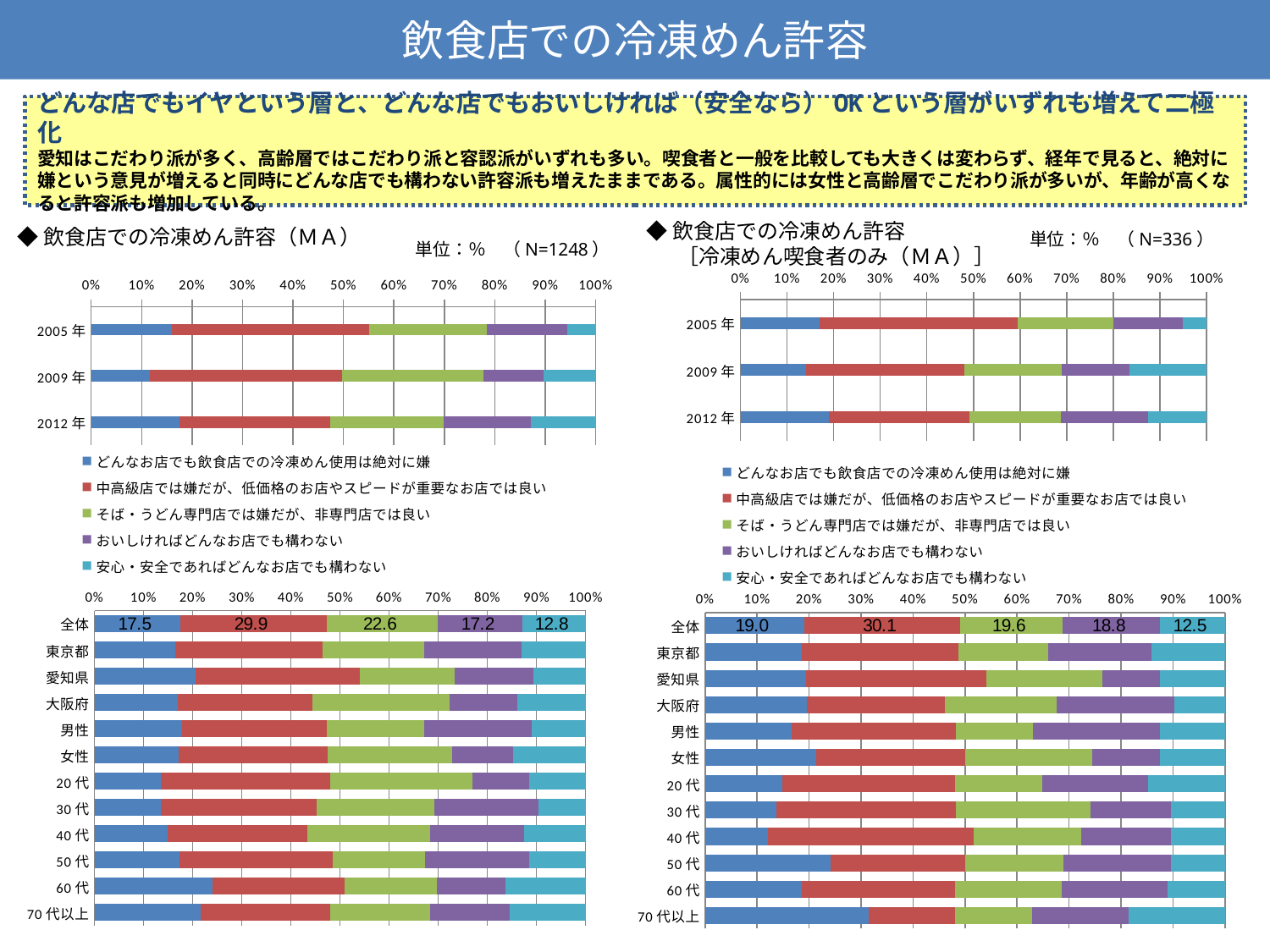
What kind of chart is the top-right chart (冷凍めん喫食者のみ)? Stacked bar chart In the bottom-left chart (N=1248), for 全体, what is the difference between the value for 中高級店では嫌だが、低価格のお店やスピードが重要なお店では良い and the value for どんなお店でも飲食店での冷凍めん使用は絶対に嫌? 12.4 How many series does the legend of the top-left chart list? 5 In the bottom-left chart (飲食店での冷凍めん許容, N=1248), what is the value for 全体 in the series どんなお店でも飲食店での冷凍めん使用は絶対に嫌? 17.5 In the bottom-left chart (N=1248), what is the total of the 全体 bar? 100.0 In the bottom-right chart (N=336), which series has the highest value for 全体? 中高級店では嫌だが、低価格のお店やスピードが重要なお店では良い In the bottom-right chart (N=336), what is the value for 全体 in the series おいしければどんなお店でも構わない? 18.8 In the bottom-left chart (N=1248), what is the value for 全体 in the series 安心・安全であればどんなお店でも構わない? 12.8 In the bottom-left chart (N=1248), for 全体, which is larger: そば・うどん専門店では嫌だが、非専門店では良い or おいしければどんなお店でも構わない? そば・うどん専門店では嫌だが、非専門店では良い In the bottom-right chart (冷凍めん喫食者のみ, N=336), what is the value for 全体 in the series 中高級店では嫌だが、低価格のお店やスピードが重要なお店では良い? 30.1 How many categories are shown on the y axis of the bottom-left chart (N=1248)? 12 In the top-left chart (N=1248), is the value for 2005年 in the series どんなお店でも飲食店での冷凍めん使用は絶対に嫌 greater or less than 20%? less